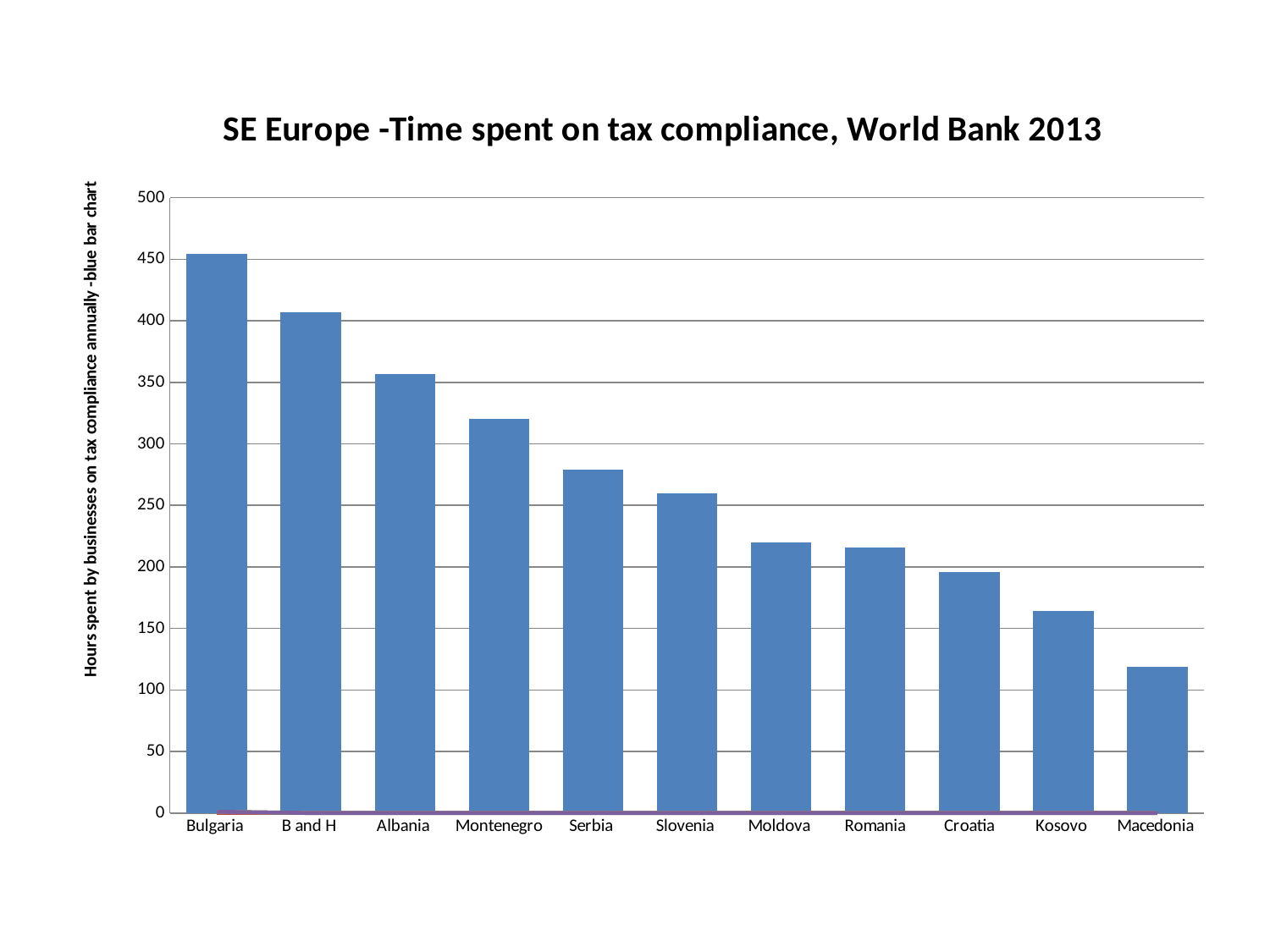
Which country has the lowest number of hours spent on tax compliance? Macedonia Which has a larger value, Albania or Serbia? Albania Do the bar values rise or fall from left to right along the x axis? fall Is the value for Macedonia greater or less than 150? less Is the value for Serbia greater or less than 300? less Is the value for Bulgaria greater or less than 400? greater What is the title of the chart? SE Europe -Time spent on tax compliance, World Bank 2013 What kind of chart is shown on the slide? bar chart Which country has the highest number of hours spent on tax compliance? Bulgaria How many countries are shown on the x axis? 11